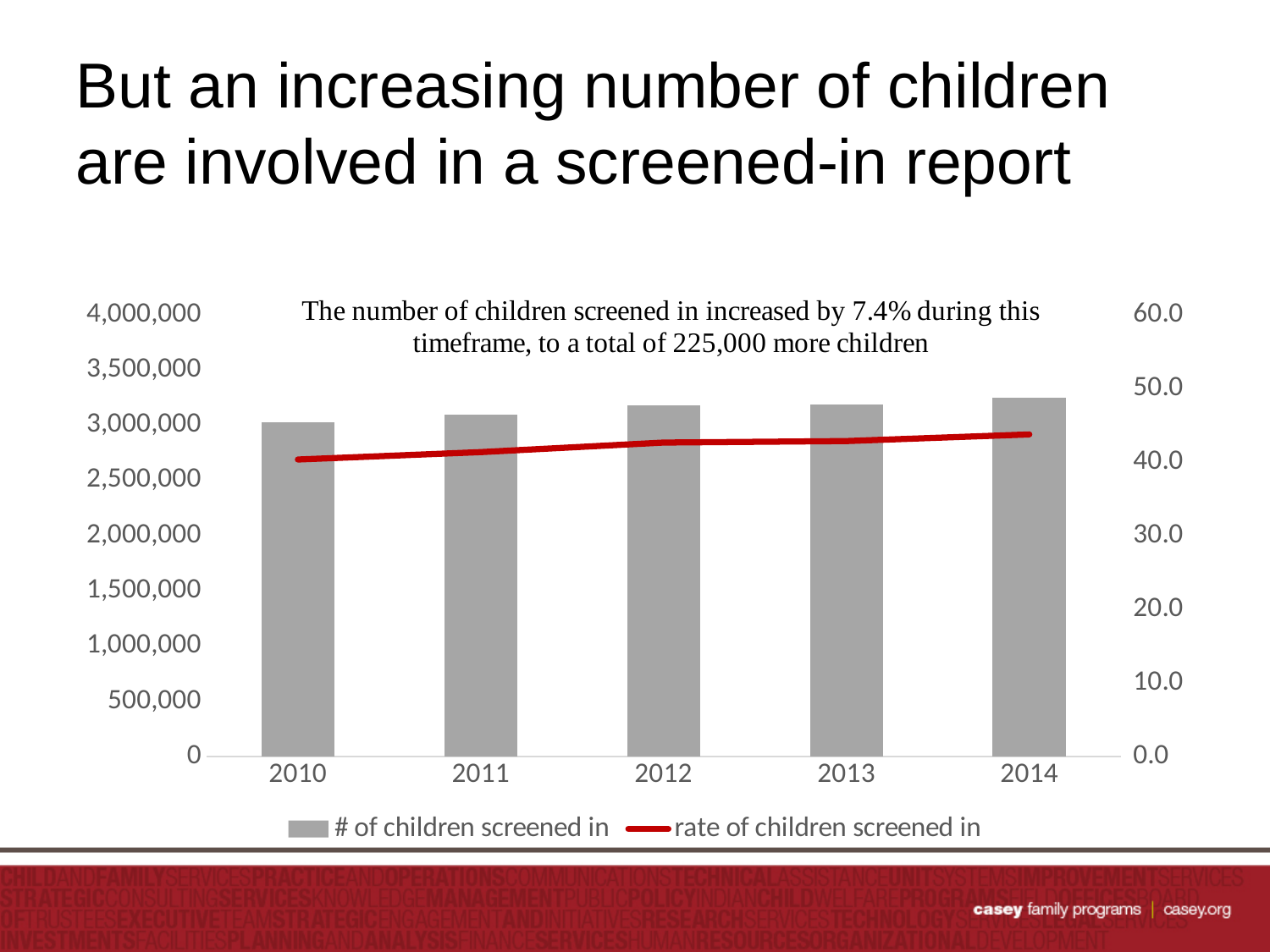
Is the rate of children screened in for 2014 greater or less than 50.0? less Which year has the lowest number of children screened in? 2010 What kind of chart is shown on the slide? A combined bar and line chart Is the number of children screened in for 2014 greater or less than 3,000,000? greater What does the red line in the chart represent, according to the legend? rate of children screened in Is the rate of children screened in for 2010 greater or less than 30.0? greater How many years are shown on the x axis of the chart? 5 Which year has a larger number of children screened in, 2010 or 2014? 2014 Which year has the highest number of children screened in? 2014 Does the number of children screened in rise or fall from 2010 to 2014? Rise How many series does the chart's legend list? 2